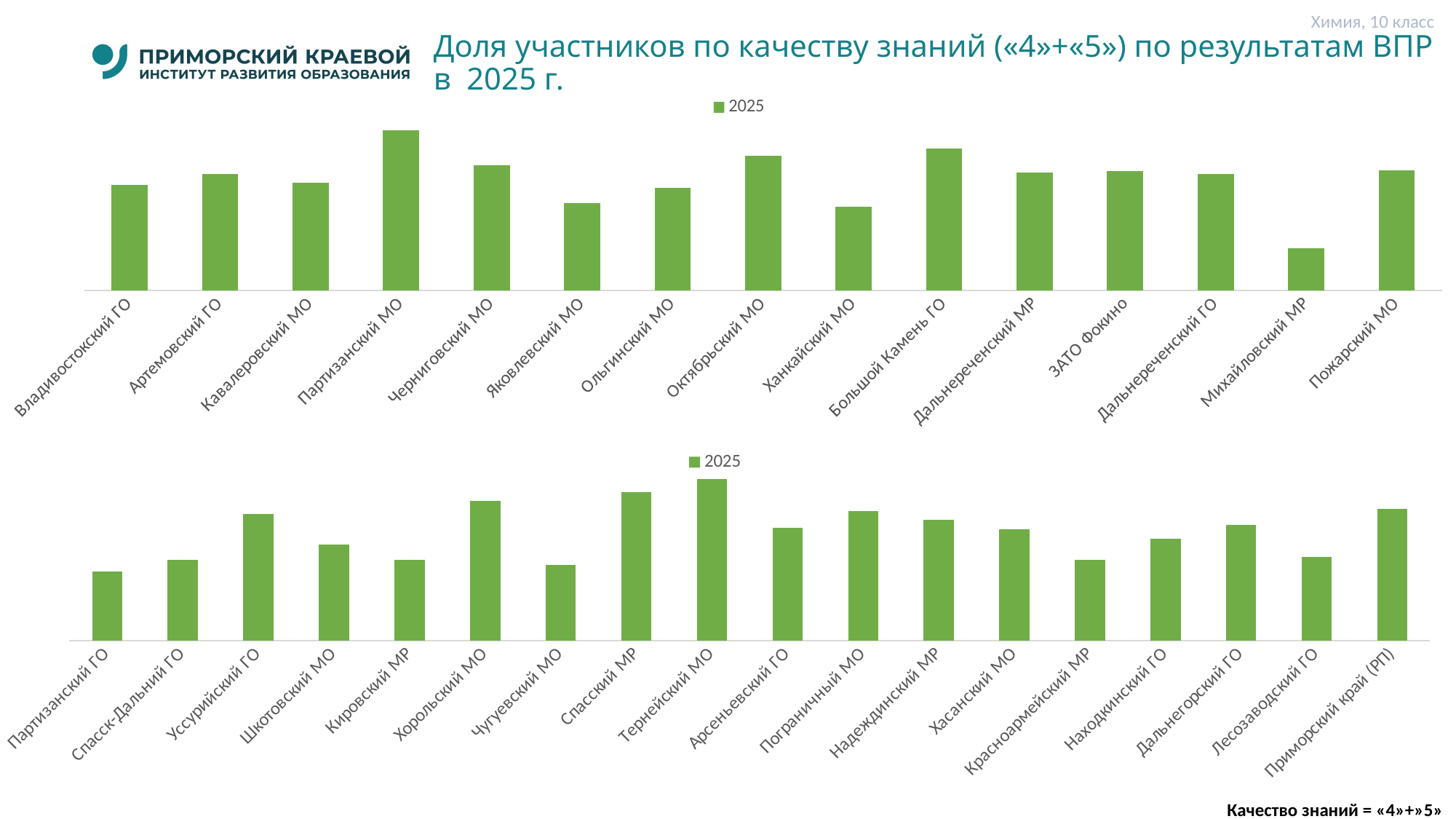
How many categories are shown in the bottom chart? 18 In the top chart, which is larger: the value for Яковлевский МО or for Большой Камень ГО? Большой Камень ГО How many categories are shown in the top chart? 15 In the top chart, which is larger: the value for Октябрьский МО or for Ханкайский МО? Октябрьский МО In the top chart, which category has the highest bar? Партизанский МО What type of chart is the bottom chart? Bar chart In the bottom chart, which category has the highest bar? Тернейский МО In the bottom chart, which is larger: the value for Хорольский МО or for Чугуевский МО? Хорольский МО How many series does the legend of the top chart list? 1 In the top chart, which category has the lowest bar? Михайловский МР